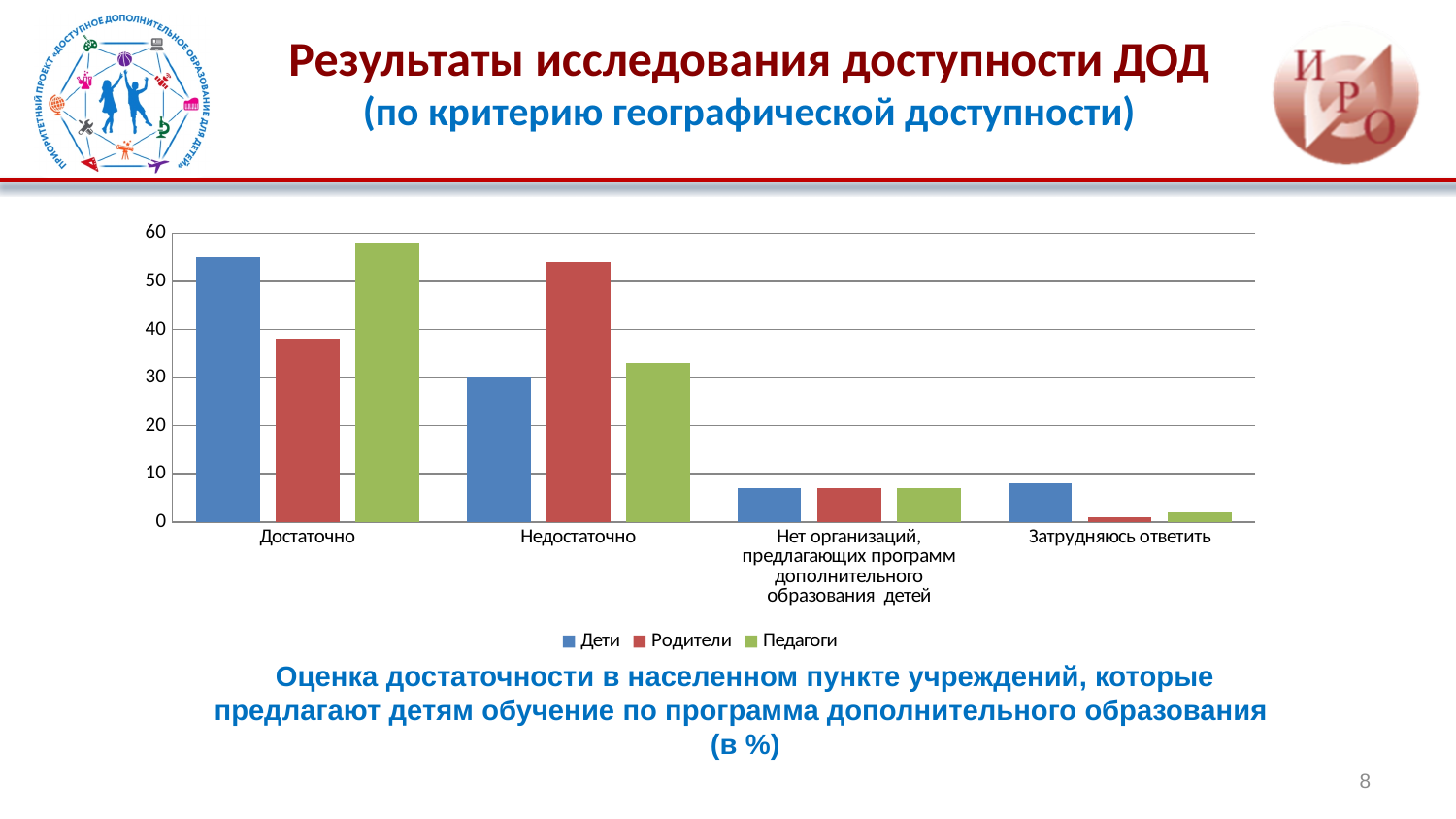
How many categories are shown on the x axis? 4 Is the value for Дети in the category Затрудняюсь ответить greater or less than 10? less What kind of chart is shown on the slide? bar chart Which series has the highest value for the category Достаточно? Педагоги Which is larger: the value for Дети in Достаточно or the value for Дети in Недостаточно? Дети in Достаточно Is the value for Родители in the category Достаточно greater or less than 40? less How many series does the legend list? 3 Which legend entry is shown in green? Педагоги Is the value for Педагоги in the category Достаточно greater or less than 50? greater Which series has the highest value for the category Недостаточно? Родители Which series has the lowest value for the category Достаточно? Родители Which series has the lowest value for the category Затрудняюсь ответить? Родители